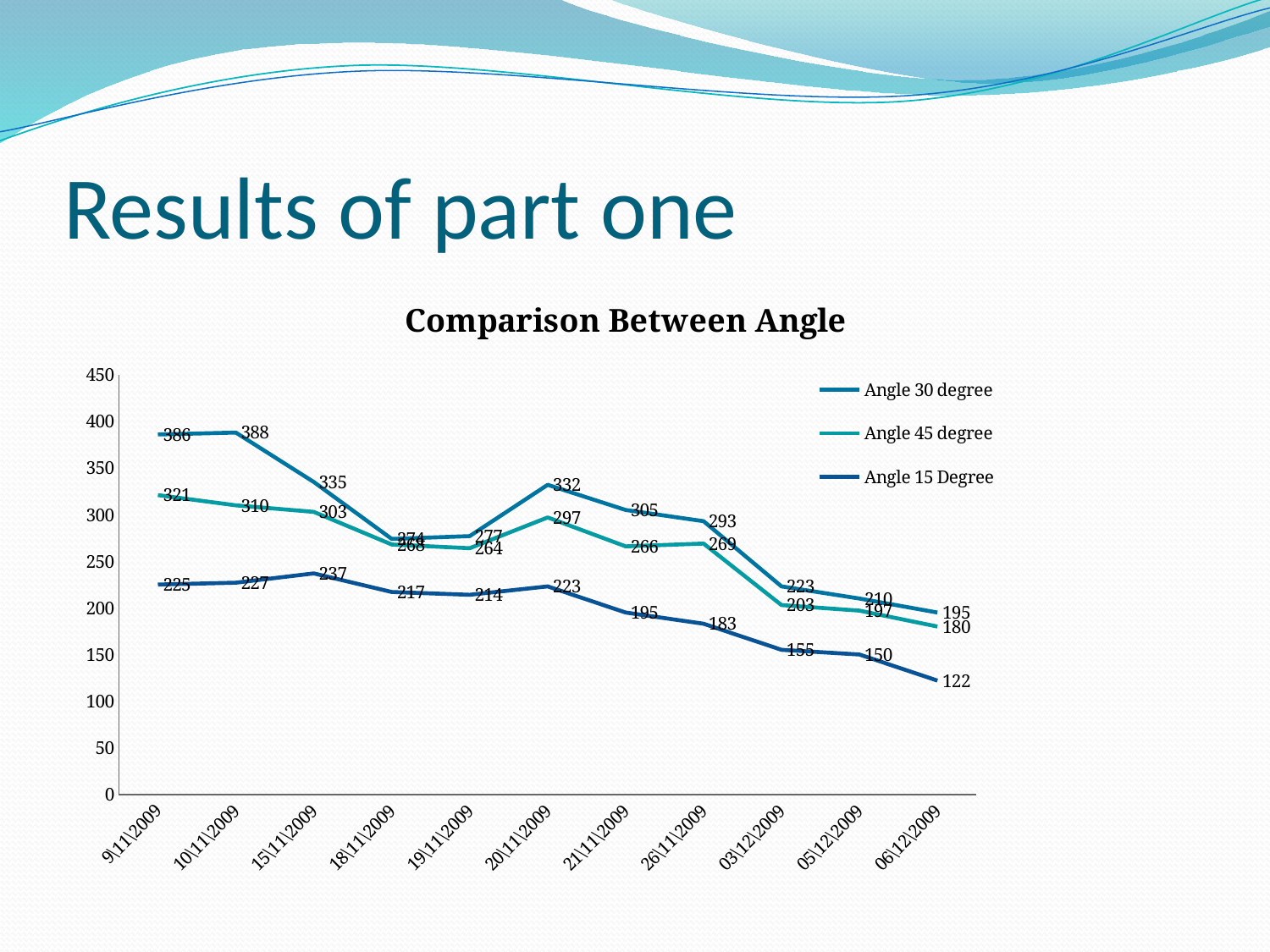
What is the difference between Angle 30 degree and Angle 45 degree on 20\11\2009? 35 What is the value for Angle 30 degree on 9\11\2009? 386 How many dates are plotted along the x axis of the chart? 11 On which date does Angle 30 degree reach its highest value? 10\11\2009 Do the values for Angle 15 Degree rise or fall from 20\11\2009 to 06\12\2009? fall What kind of chart is shown on the slide? line chart What is the value for Angle 45 degree on 20\11\2009? 297 For Angle 15 Degree, which date has the larger value: 15\11\2009 or 20\11\2009? 15\11\2009 What is the value for Angle 15 Degree on 06\12\2009? 122 Is the value for Angle 45 degree on 03\12\2009 greater or less than 250? less On which date does Angle 15 Degree reach its lowest value? 06\12\2009 How many series does the legend of the chart list? 3